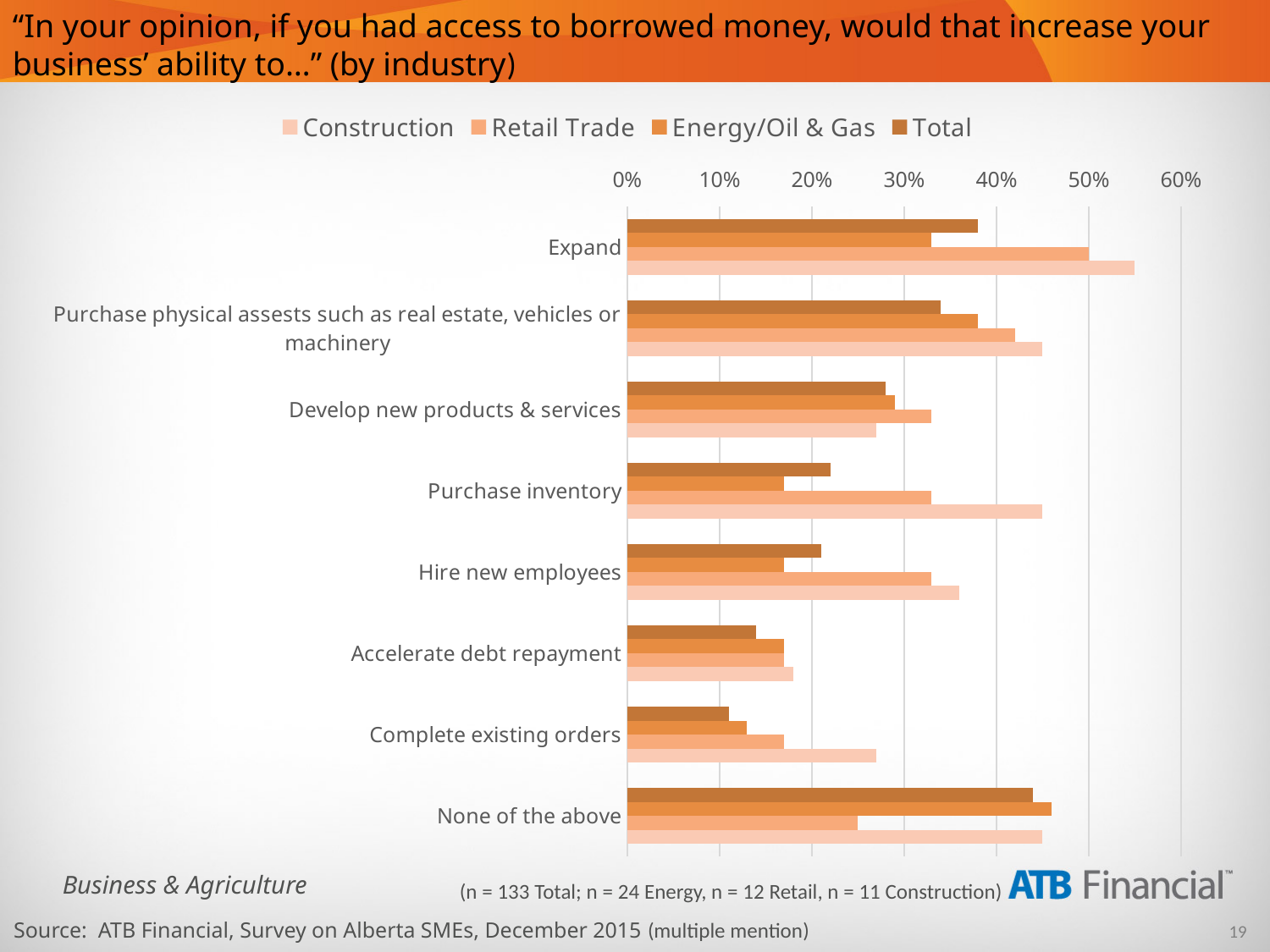
Which category has the lowest Total value? Complete existing orders Is the Total value for Complete existing orders greater or less than 20%? less For Expand, which is larger: the Construction value or the Energy/Oil & Gas value? Construction What are the four series listed in the legend? Construction, Retail Trade, Energy/Oil & Gas, Total How many series does the legend list? 4 Is the Energy/Oil & Gas value for Hire new employees greater or less than 20%? less What kind of chart is shown on the slide? bar chart Is the Construction value for Purchase inventory greater or less than 40%? greater Which category has the highest Construction value? Expand How many categories are plotted on the vertical axis? 8